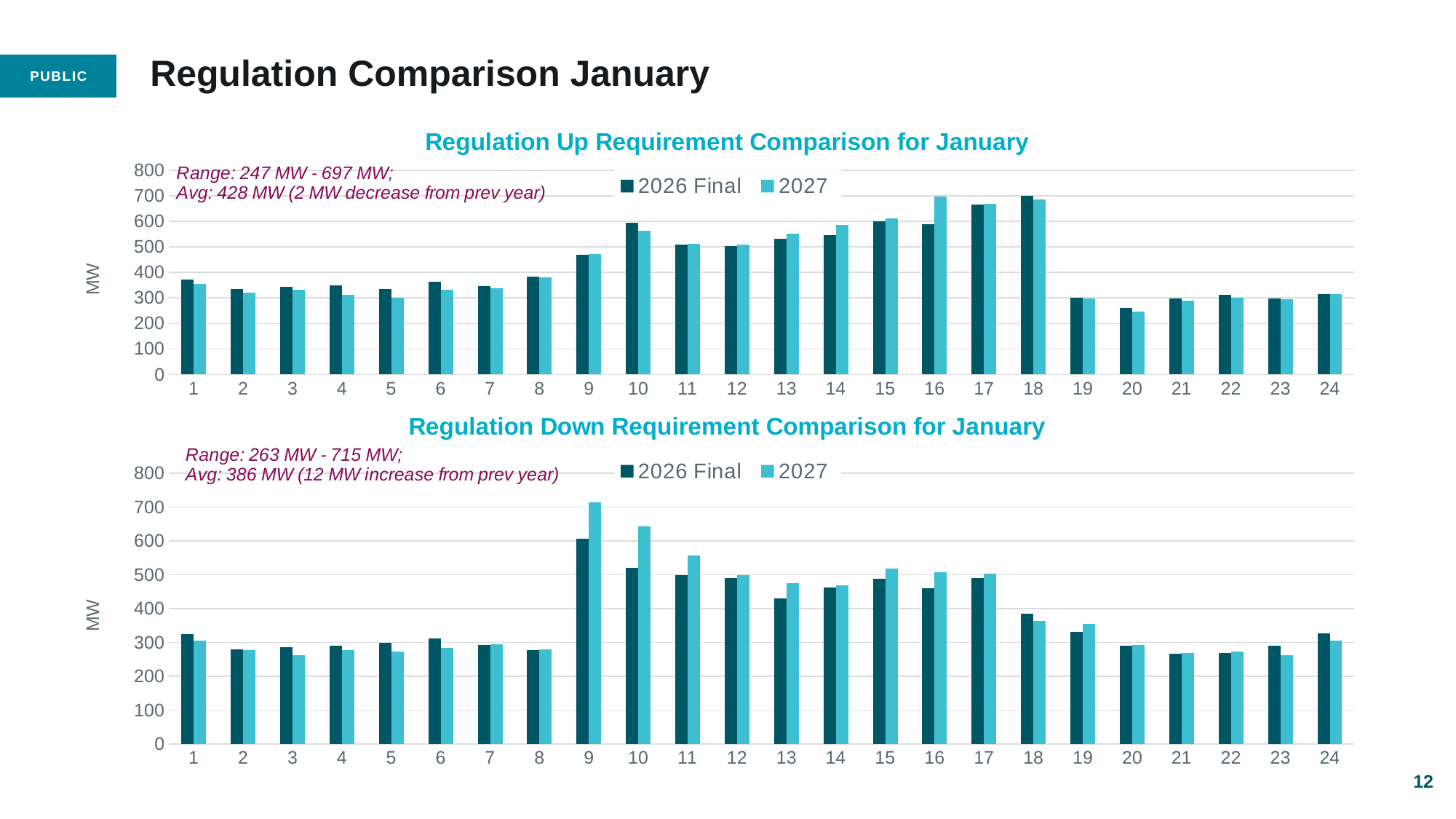
In the 'Regulation Down Requirement Comparison for January' chart, which hour has the highest 2027 value? 9 How many hour categories are shown on the x axis of the 'Regulation Up Requirement Comparison for January' chart? 24 In the 'Regulation Up Requirement Comparison for January' chart, which hour has the lowest 2027 value? 20 In the 'Regulation Up Requirement Comparison for January' chart, is the 2026 Final value for hour 10 greater or less than 500? greater In the 'Regulation Down Requirement Comparison for January' chart, at hour 11, which series has the larger value, 2026 Final or 2027? 2027 What is the y-axis label of the 'Regulation Down Requirement Comparison for January' chart? MW In the 'Regulation Down Requirement Comparison for January' chart, which hour has the highest 2026 Final value? 9 In the 'Regulation Up Requirement Comparison for January' chart, which hour has the highest 2027 value? 16 How many series does the legend list in the 'Regulation Down Requirement Comparison for January' chart? 2 In the 'Regulation Down Requirement Comparison for January' chart, is the 2027 value for hour 9 greater or less than 700? greater In the 'Regulation Up Requirement Comparison for January' chart, at hour 10, which series has the larger value, 2026 Final or 2027? 2026 Final What kind of chart is the 'Regulation Up Requirement Comparison for January' chart? bar chart